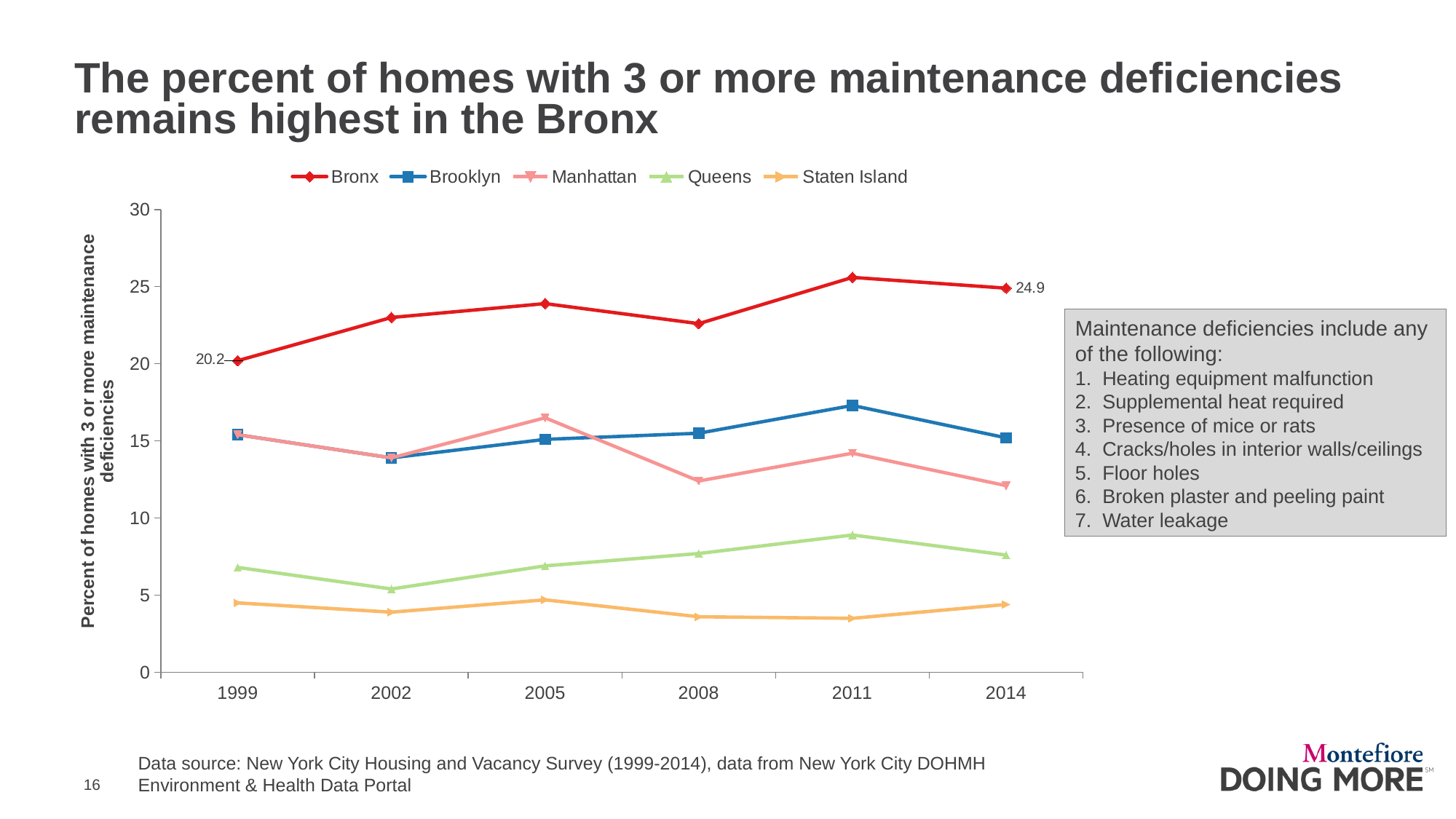
Is the value for Queens in 2011 greater or less than 10? less How many series does the legend list? 5 What kind of chart is shown on the slide? Line chart Is the value for Brooklyn in 2011 greater or less than 15? greater Which borough has the highest value in 2014? Bronx How many years are shown on the x axis? 6 In 2005, which is larger: the value for Manhattan or the value for Brooklyn? Manhattan What is the value for the Bronx in 1999? 20.2 Does the Manhattan line rise or fall overall from 1999 to 2014? fall By how much did the Bronx value increase from 1999 to 2014? 4.7 Which borough has the lowest value in 2014? Staten Island What is the value for the Bronx in 2014? 24.9